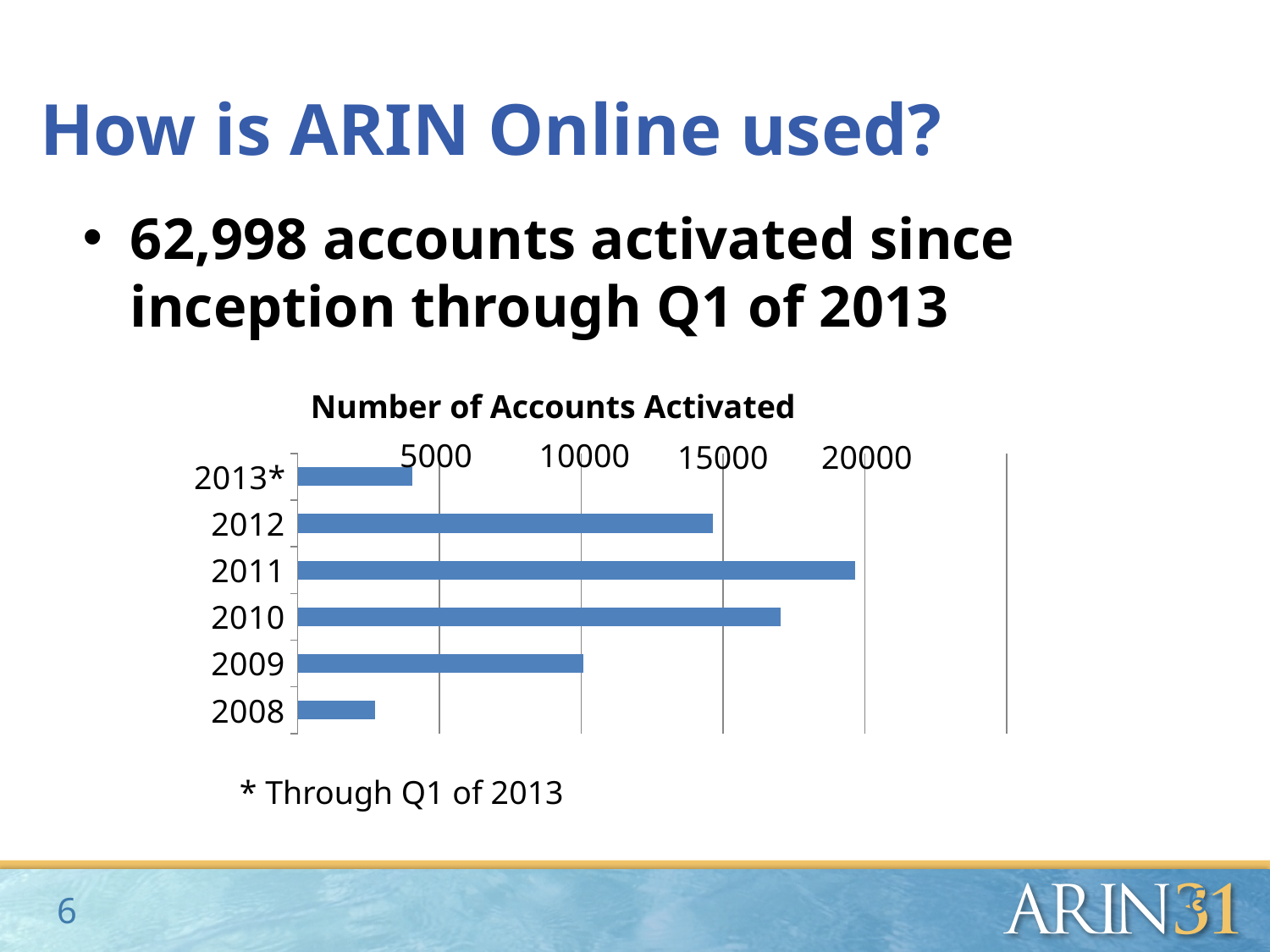
Is the value for 2009 greater or less than 5000? greater Is the value for 2012 greater or less than 15000? less What does the asterisk next to 2013 indicate, according to the note below the chart? Through Q1 of 2013 Which year has the lowest number of accounts activated? 2008 Is the value for 2013* greater or less than 5000? less What kind of chart is shown on the slide? bar chart Which year had more accounts activated, 2011 or 2010? 2011 Which year had more accounts activated, 2010 or 2012? 2010 How many years (categories) are plotted in the chart? 6 Which year has the highest number of accounts activated? 2011 What is the title of the chart? Number of Accounts Activated